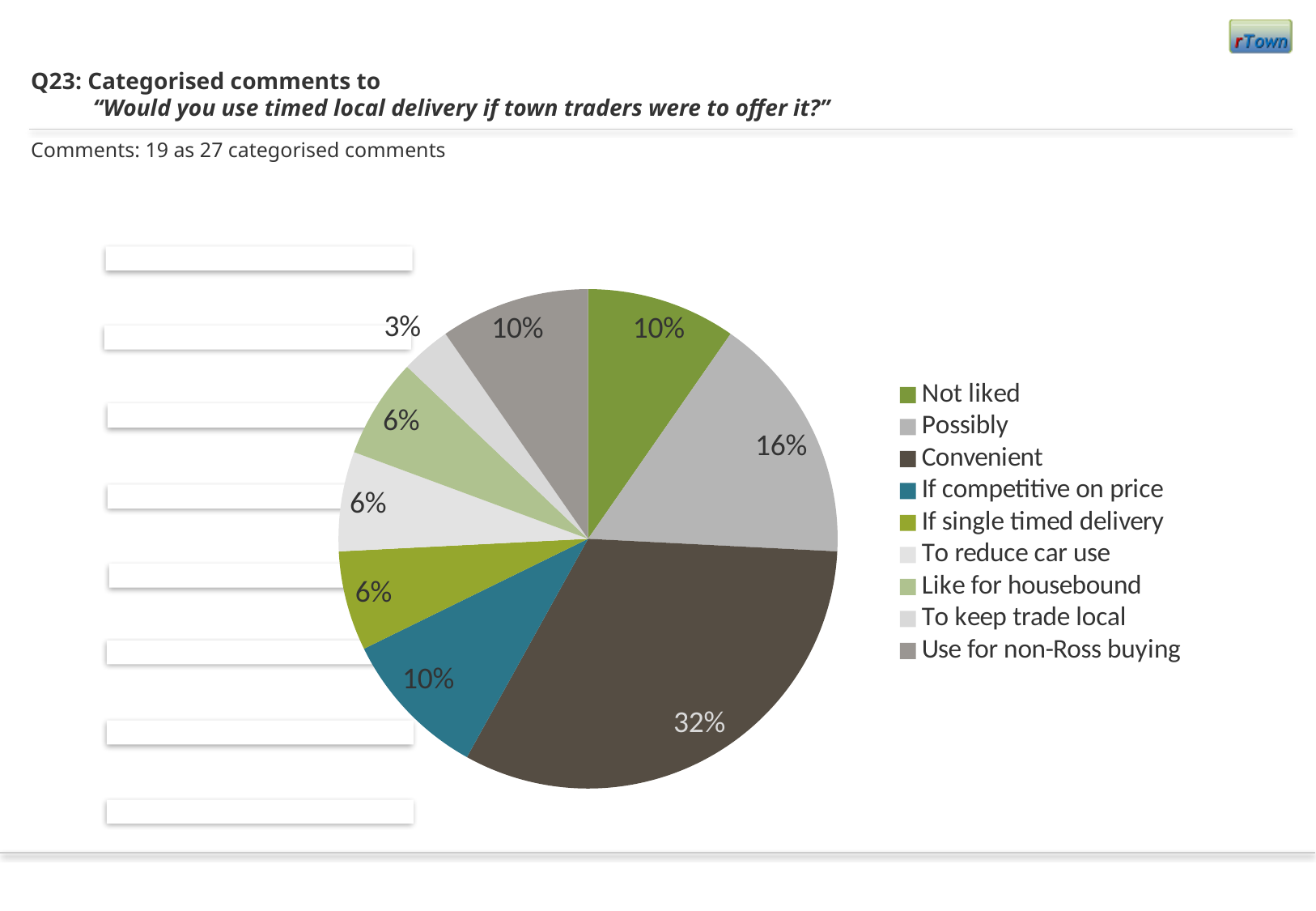
How many categories does the pie chart have? 9 What percentage of comments were categorised as "Possibly"? 16% What is the last entry listed in the legend? Use for non-Ross buying How many percentage points larger is "Convenient" than "Possibly"? 16 Which has a larger share, "Not liked" or "If single timed delivery"? Not liked What percentage is shown for "Like for housebound"? 6% What percentage is shown for "If competitive on price"? 10% Which category has the largest share of the pie? Convenient What share of the pie is "To keep trade local"? 3% What kind of chart is shown on the slide? Pie chart What percentage of comments were categorised as "Convenient"? 32% Which category has the smallest share of the pie? To keep trade local